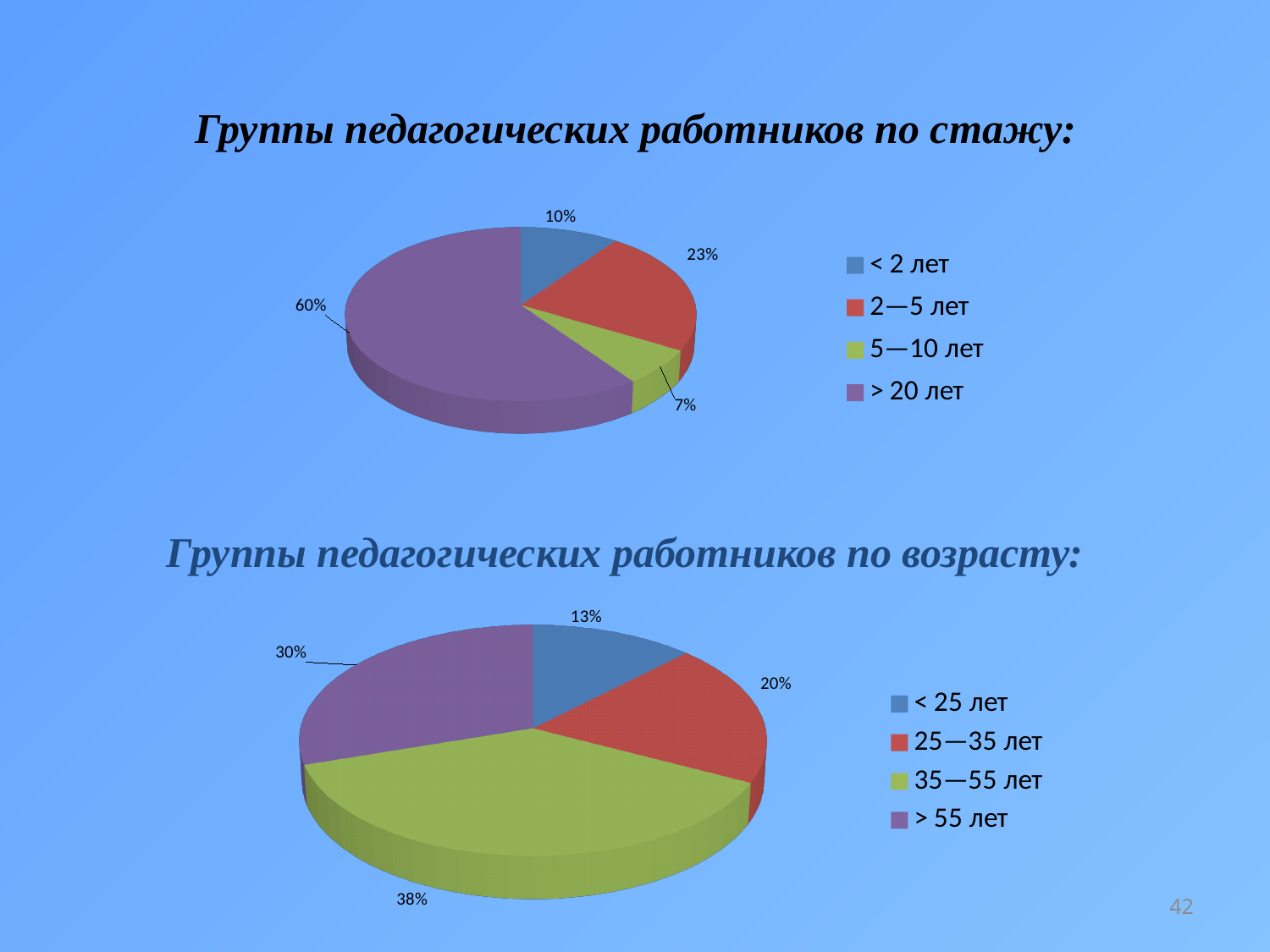
In the top chart (Группы педагогических работников по стажу), which category has the largest slice? > 20 лет In the bottom chart (Группы педагогических работников по возрасту), which category has the smallest slice? < 25 лет In the bottom chart (Группы педагогических работников по возрасту), which is larger: '25—35 лет' or '> 55 лет'? > 55 лет In the top chart (Группы педагогических работников по стажу), what is the difference between the '2—5 лет' and '< 2 лет' slices? 13% In the bottom chart (Группы педагогических работников по возрасту), what share of the pie is the '> 55 лет' slice? 30% What type of chart is used for the bottom chart (Группы педагогических работников по возрасту)? Pie chart In the bottom chart (Группы педагогических работников по возрасту), what is the difference between the '35—55 лет' and '< 25 лет' slices? 25% In the top chart (Группы педагогических работников по стажу), which category has the smallest slice? 5—10 лет In the top chart (Группы педагогических работников по стажу), how many categories does the legend list? 4 In the top chart (Группы педагогических работников по стажу), what is the value for '2—5 лет'? 23% In the top chart (Группы педагогических работников по стажу), what share of the pie is the '> 20 лет' slice? 60% In the bottom chart (Группы педагогических работников по возрасту), what is the value for '35—55 лет'? 38%